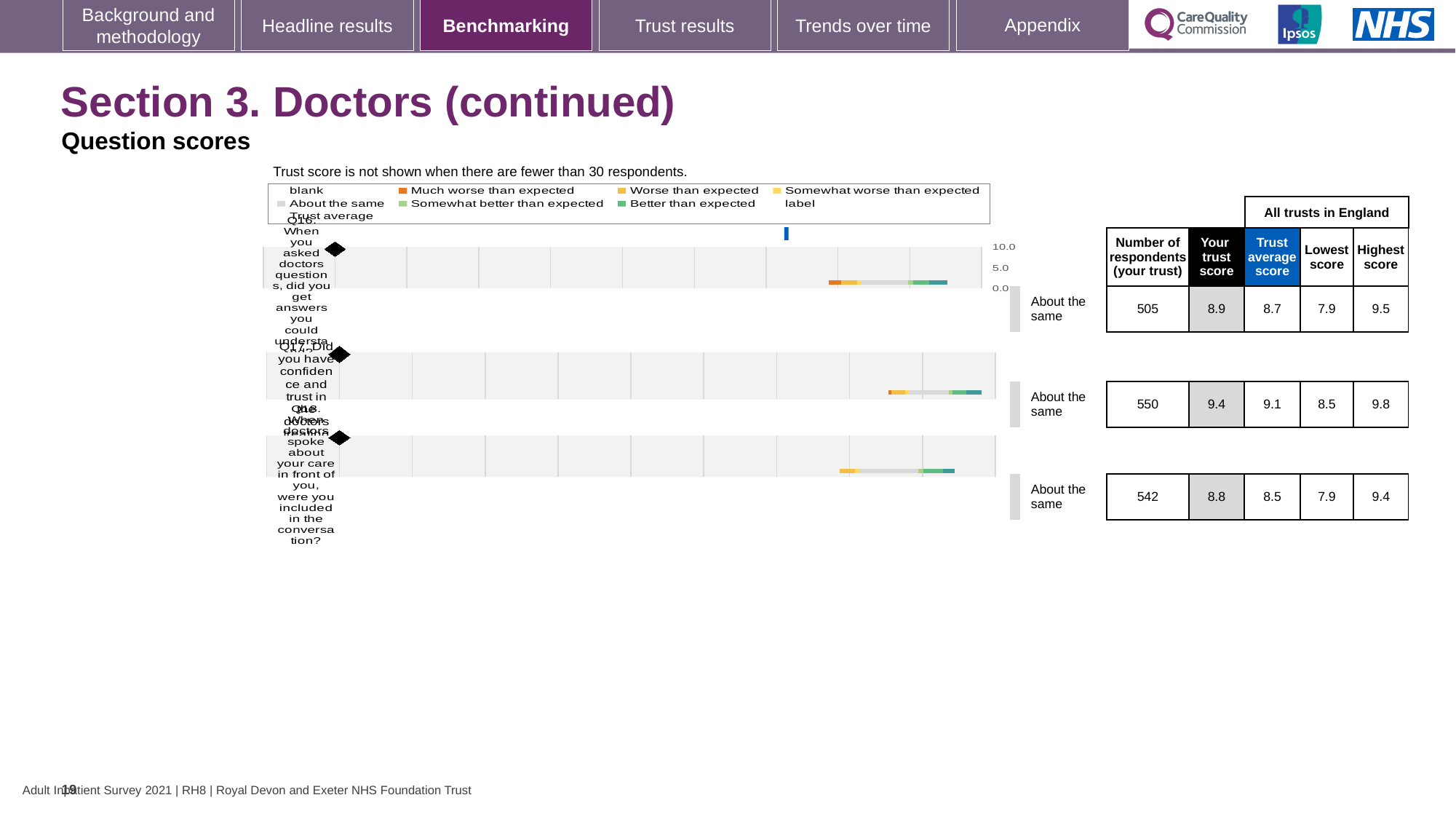
What kind of chart is used to show the question scores? Bar chart What is the lowest score across all trusts in England for Q16? 7.9 What is the difference between your trust score and the trust average score for Q17? 0.3 What is the highest score across all trusts in England for Q17? 9.8 What is the trust average score for Q18 (being included in the conversation when doctors spoke about your care)? 8.5 What benchmark category is shown next to the bar for Q18? About the same Which question has the highest 'Your trust score'? Q17 How many questions are plotted on the chart? 3 How many respondents from your trust answered Q17 (confidence and trust in the doctors)? 550 Which is larger: your trust score for Q16 or your trust score for Q18? Q16 Which question has the lowest 'Your trust score'? Q18 What is your trust score for Q16 (getting answers you could understand from doctors)? 8.9